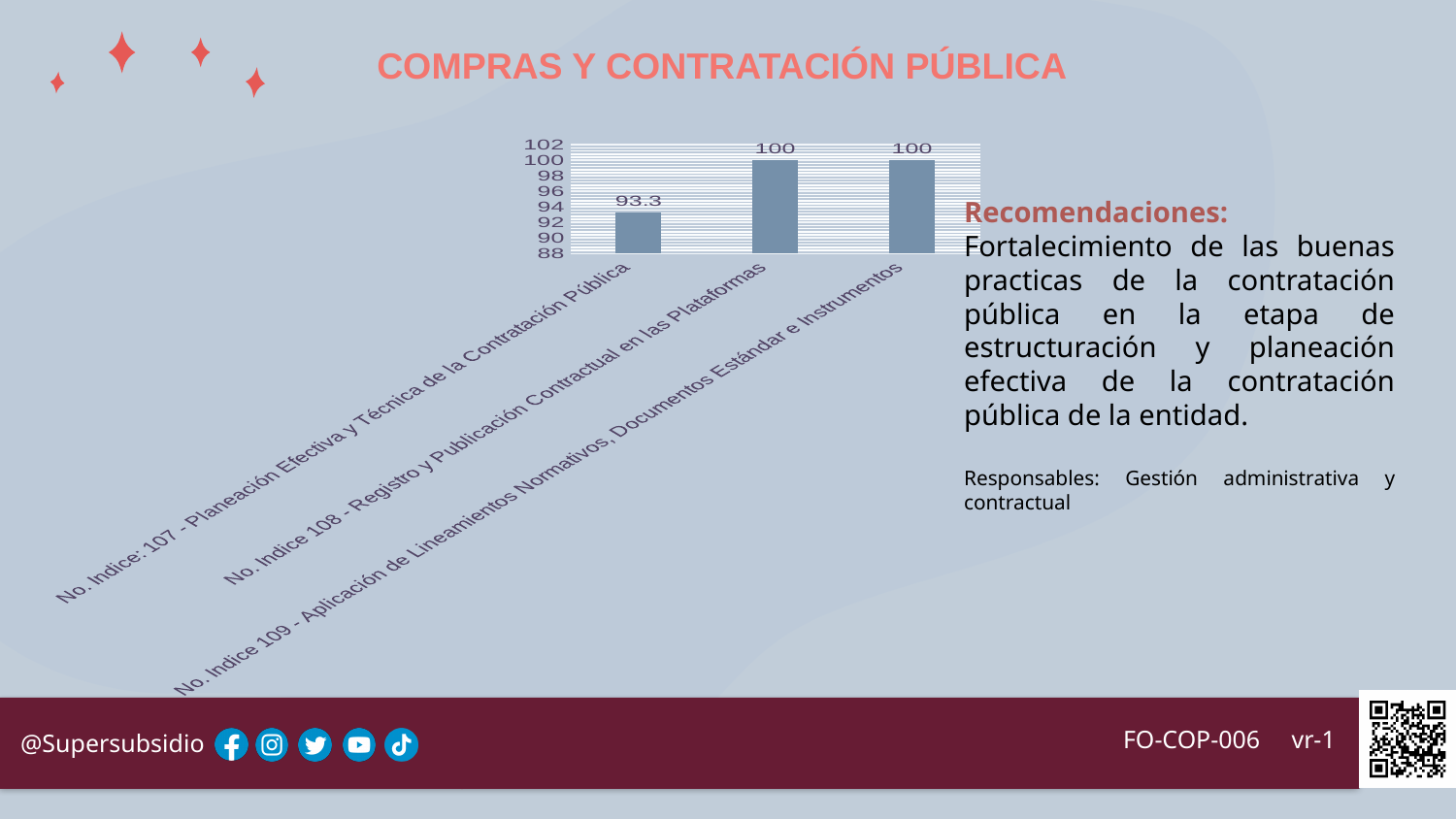
Is the value for Indice 107 greater or less than 96? less What kind of chart is shown on the slide? bar chart What is the value for 'No. Indice: 107 - Planeación Efectiva y Técnica de la Contratación Pública'? 93.3 Is the value for Indice 108 greater or less than 98? greater What is the difference between the value for Indice 108 and the value for Indice 107? 6.7 How many categories are shown in the chart? 3 What is the value for 'No. Indice 108 - Registro y Publicación Contractual en las Plataformas'? 100 Which category has the lowest value? No. Indice: 107 - Planeación Efectiva y Técnica de la Contratación Pública Do the values rise or fall from Indice 107 to Indice 108? rise What is the lowest value shown on the vertical axis of the chart? 88 What is the value for 'No. Indice 109 - Aplicación de Lineamientos Normativos, Documentos Estándar e Instrumentos'? 100 Which is larger, the value for Indice 107 or the value for Indice 109? Indice 109